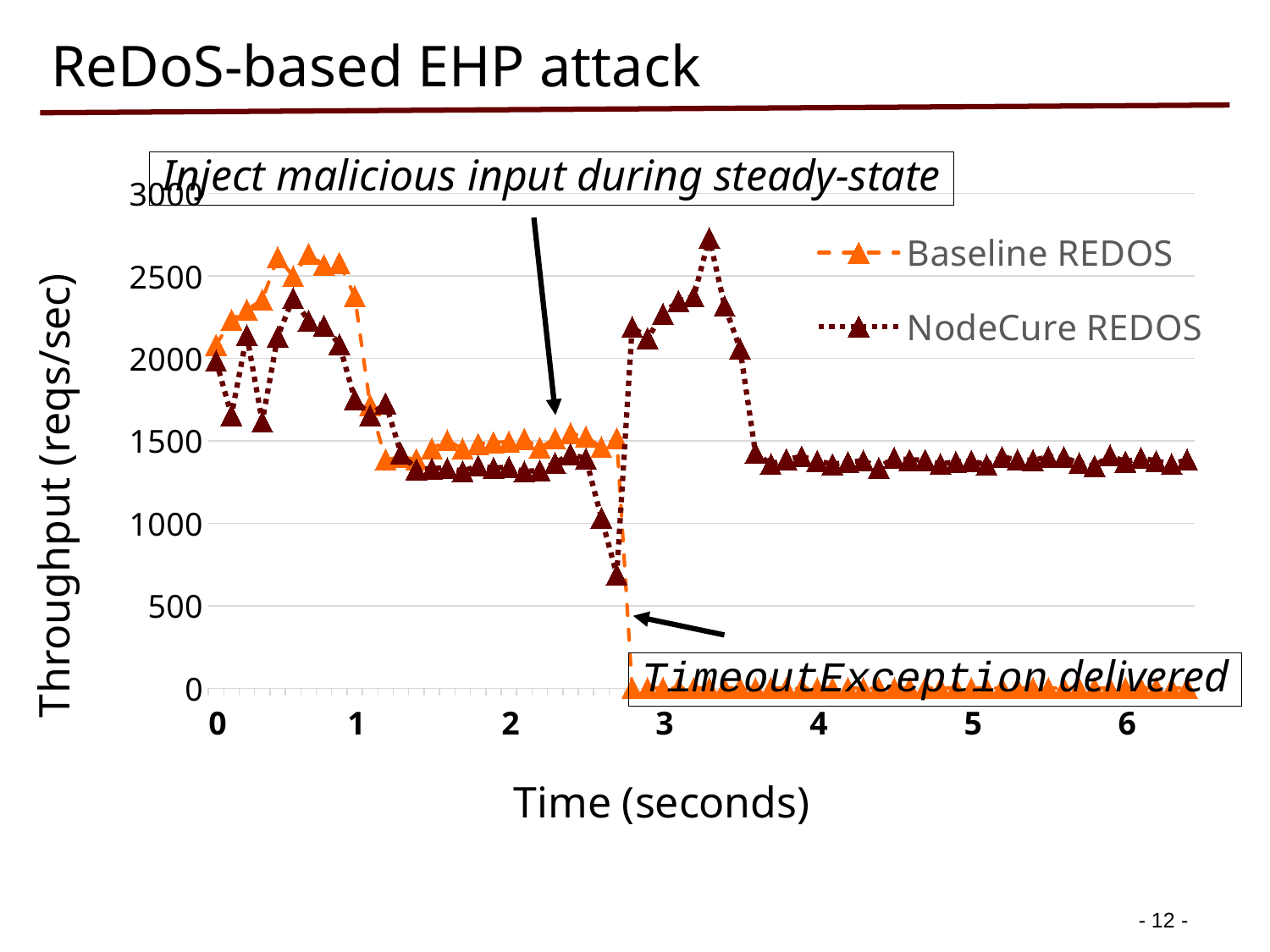
Does the Baseline REDOS throughput rise or fall between 2.5 and 3 seconds? fall Is the peak NodeCure REDOS throughput near 3.3 seconds greater or less than 2500? greater Does the NodeCure REDOS throughput rise or fall between 2.8 and 3.3 seconds? rise What kind of chart is shown on the slide? line chart Is the NodeCure REDOS throughput at 5 seconds greater or less than 1000? greater Is the Baseline REDOS throughput at 0.5 seconds greater or less than 2000? greater How many series does the legend list? 2 At 4 seconds, which series has the higher throughput, Baseline REDOS or NodeCure REDOS? NodeCure REDOS What are the two series named in the legend? Baseline REDOS and NodeCure REDOS What is the label of the y axis? Throughput (reqs/sec)